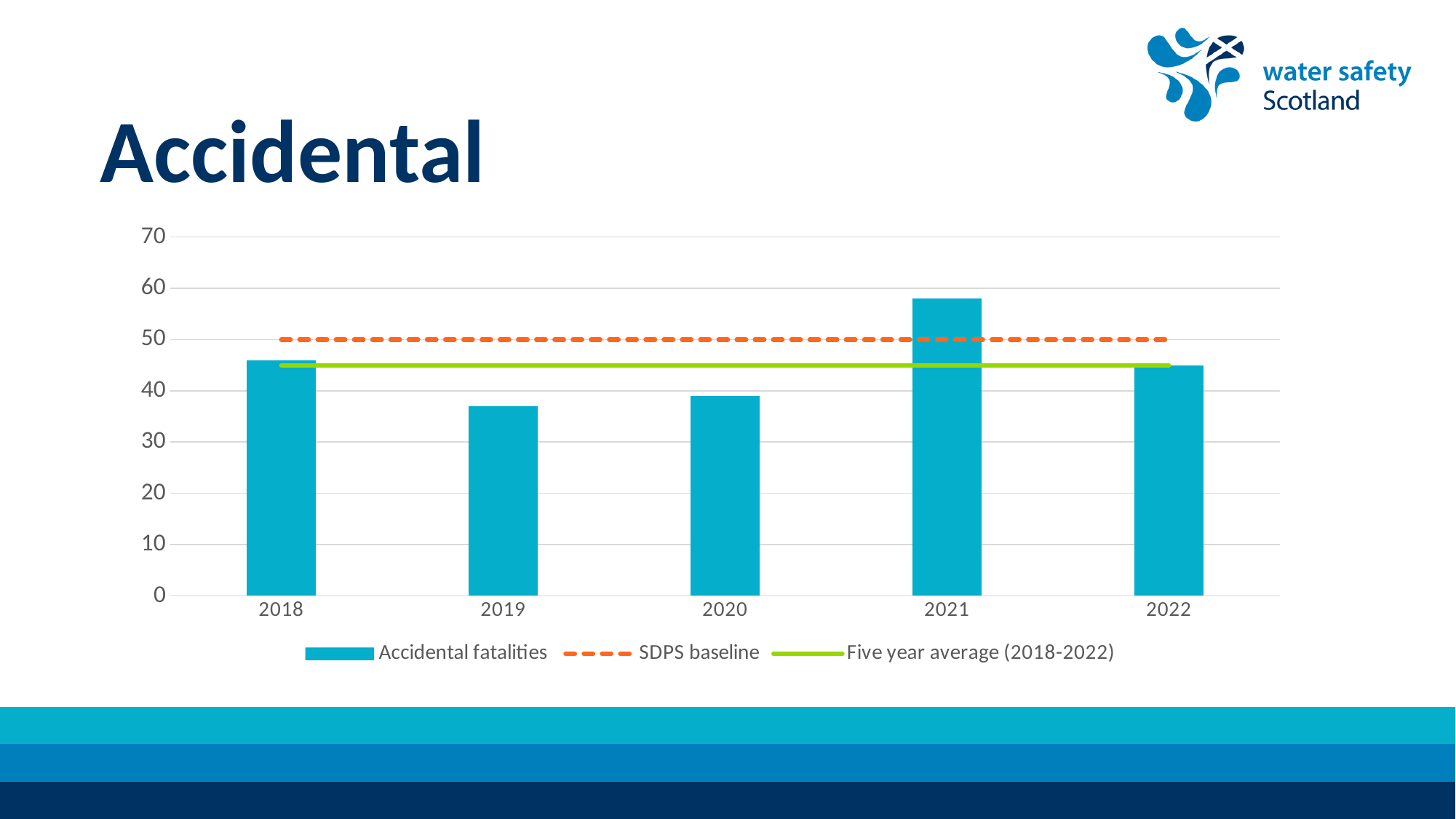
Is the value for accidental fatalities in 2020 greater or less than 40? less Is the value for accidental fatalities in 2021 greater or less than 50? greater How many years are shown on the x axis of the chart? 5 Which is larger, accidental fatalities in 2021 or in 2018? 2021 How many series does the chart legend list? 3 What kind of chart is shown on the slide? Combination bar and line chart What is the title of the slide containing the chart? Accidental Which legend entry is shown as a dashed orange line? SDPS baseline Which year has the lowest number of accidental fatalities? 2019 Which year has the highest number of accidental fatalities? 2021 At what value does the SDPS baseline line sit on the chart? 50 Is the value for accidental fatalities in 2019 greater or less than 40? less